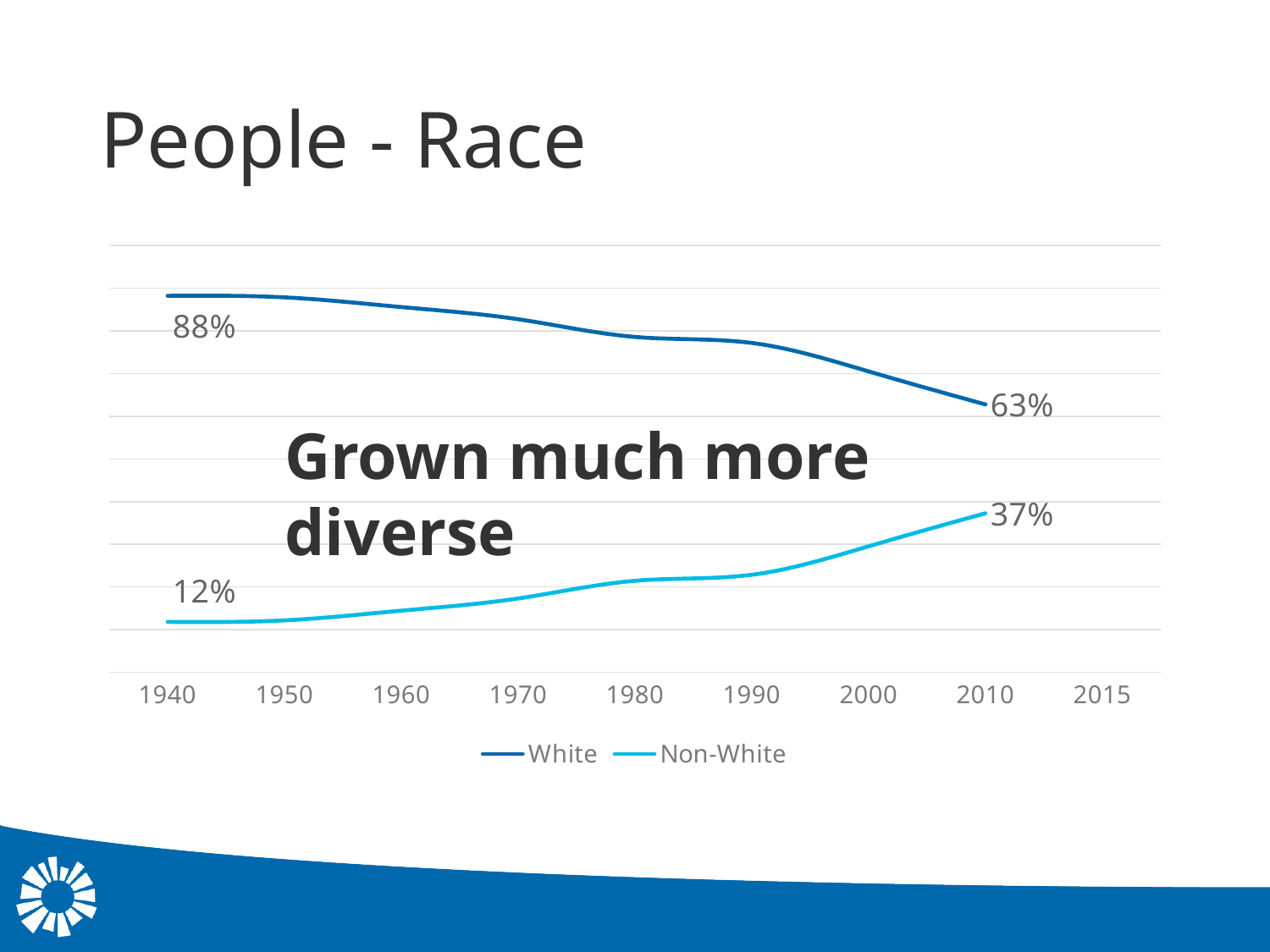
What is the difference between the White and Non-White values in 2010? 26 percentage points How many series does the legend list? 2 In 2010, which series has the larger value, White or Non-White? White What is the value for White in 1940? 88% What is the value for White in 2010? 63% What are the two entries in the chart legend? White and Non-White What is the value for Non-White in 2010? 37% What kind of chart is shown on the slide? Line chart Does the Non-White line rise or fall from 1940 to 2010? Rise By how many percentage points did the White share fall between 1940 and 2010? 25 percentage points What is the value for Non-White in 1940? 12% Does the White line rise or fall from 1940 to 2010? Fall